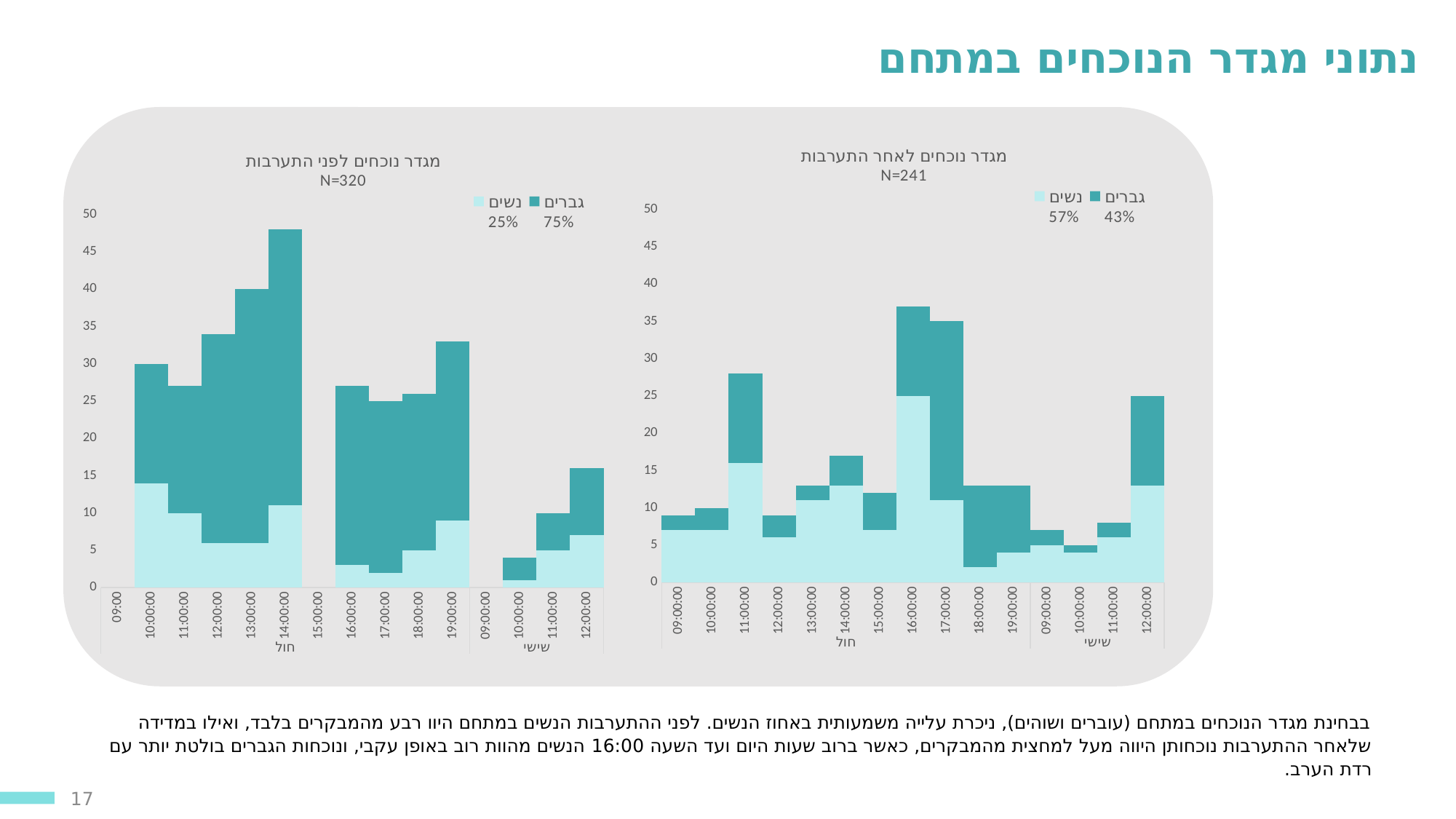
In the right chart (מגדר נוכחים לאחר התערבות), is the total for 11:00:00 (חול) greater or less than 25? greater In the right chart (מגדר נוכחים לאחר התערבות), is the total for 18:00:00 (חול) greater or less than 15? less In the right chart (מגדר נוכחים לאחר התערבות), which time category has the highest total? 16:00:00 (חול) What percentage is shown for נשים in the legend of the left chart (מגדר נוכחים לפני התערבות)? 25% What is the N value shown under the title of the right chart (מגדר נוכחים לאחר התערבות)? N=241 What kind of chart is the left chart (מגדר נוכחים לפני התערבות)? stacked bar chart How many series does the legend of the right chart (מגדר נוכחים לאחר התערבות) list? 2 In the right chart (מגדר נוכחים לאחר התערבות), which has the larger total: 16:00:00 (חול) or 11:00:00 (חול)? 16:00:00 (חול) In the left chart (מגדר נוכחים לפני התערבות), is the total for 14:00:00 (חול) greater or less than 45? greater In the left chart (מגדר נוכחים לפני התערבות), which time category has the highest total? 14:00:00 (חול) In the left chart (מגדר נוכחים לפני התערבות), how many time categories are shown on the x axis? 15 In the left chart (מגדר נוכחים לפני התערבות), which has the larger total: 14:00:00 (חול) or 19:00:00 (חול)? 14:00:00 (חול)